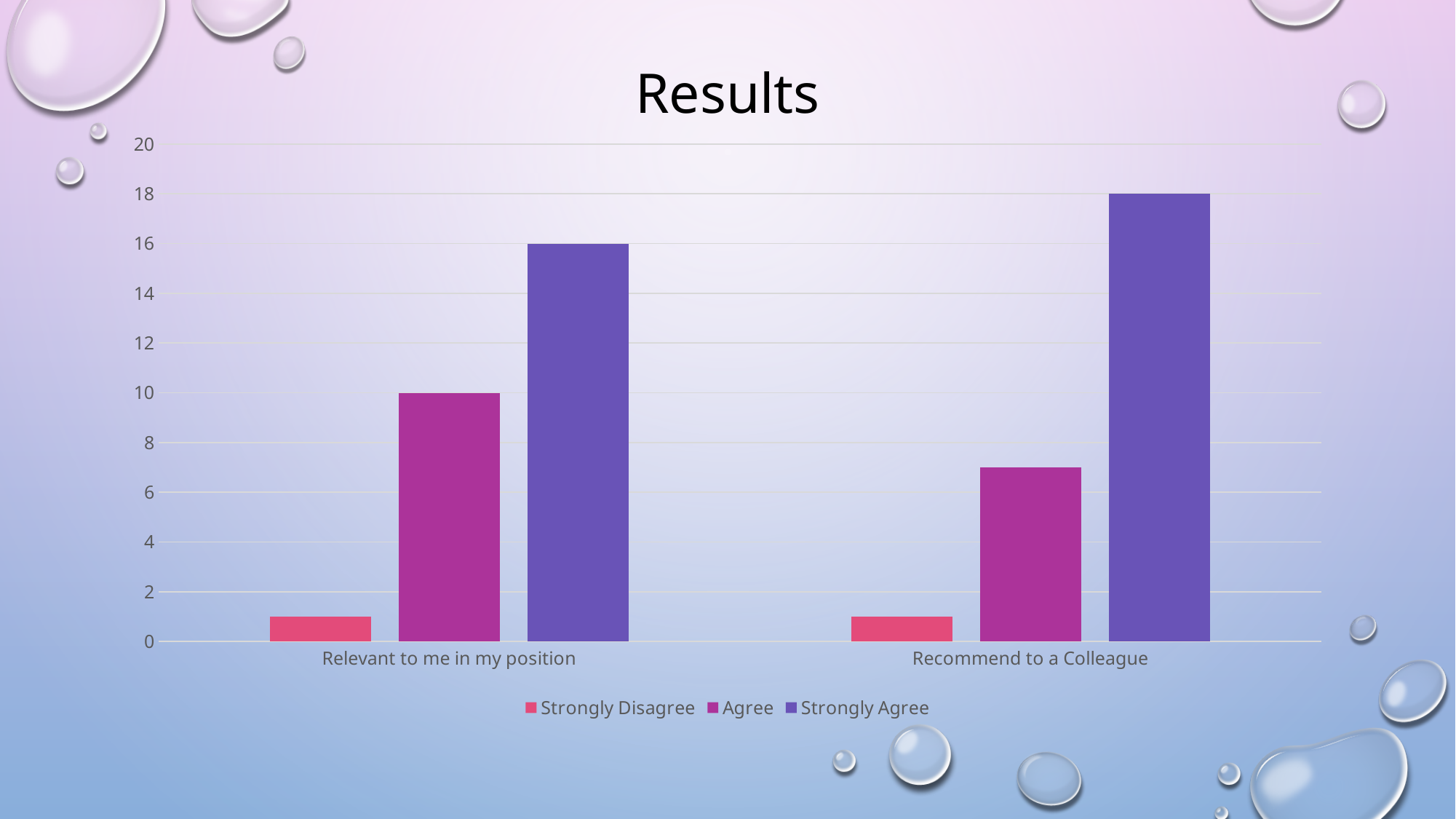
What is the value for Strongly Agree in the Recommend to a Colleague category? 18 What is the value for Strongly Agree in the Relevant to me in my position category? 16 Which series has the highest value in the Recommend to a Colleague category? Strongly Agree How many series does the legend list? 3 Which series has the lowest value in the Relevant to me in my position category? Strongly Disagree What is the title of the chart? Results What type of chart is shown on the slide? bar chart Is the value for Agree in the Recommend to a Colleague category greater or less than 8? less What is the value for Agree in the Relevant to me in my position category? 10 Is the value for Strongly Disagree in the Relevant to me in my position category greater or less than 2? less How many categories are shown on the x axis? 2 What is the difference between the Strongly Agree values for Recommend to a Colleague and Relevant to me in my position? 2